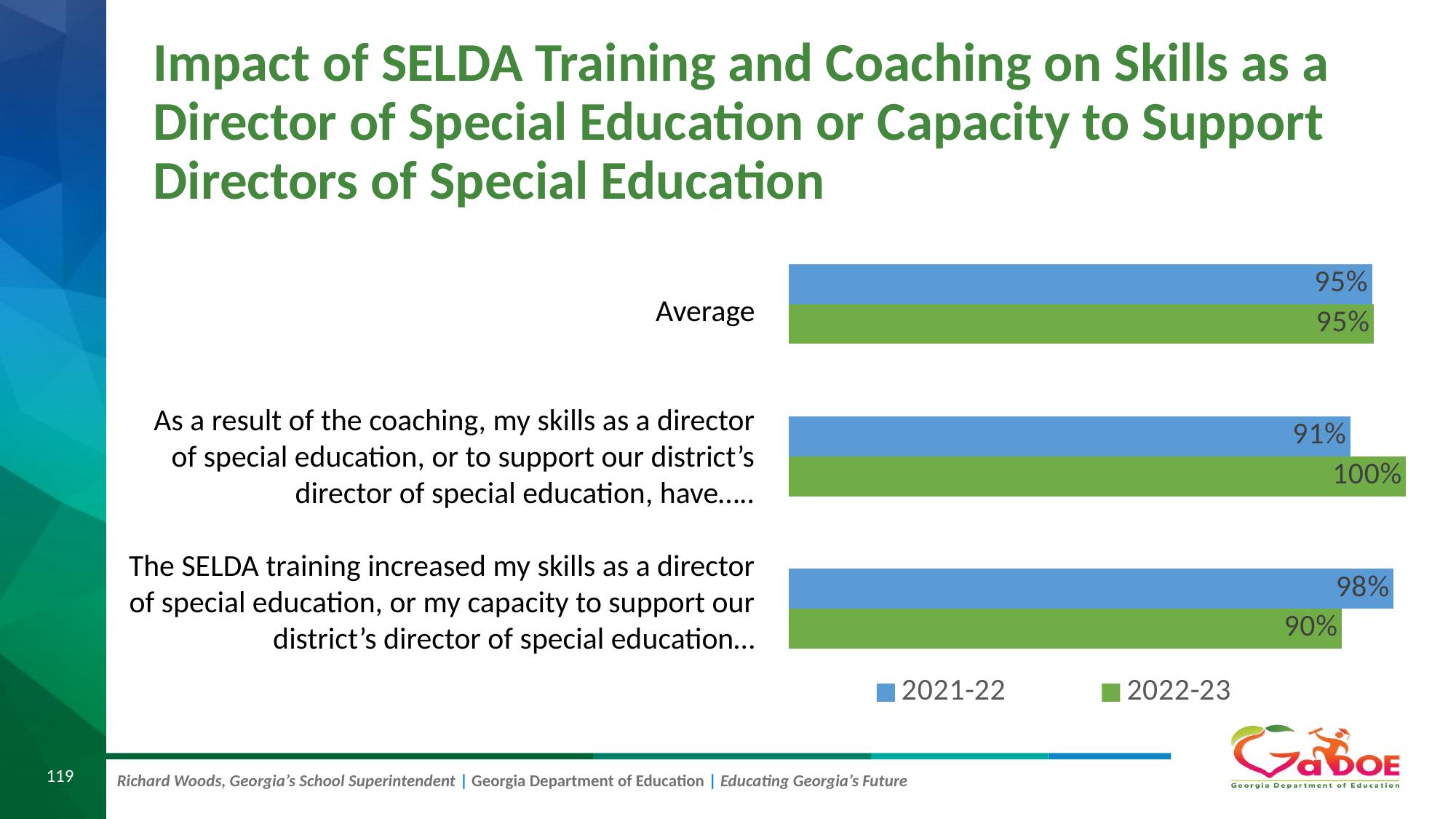
What is the difference between the 2022-23 and 2021-22 values for the category beginning 'As a result of the coaching...'? 9% What is the 2021-22 value for the category beginning 'The SELDA training increased my skills as a director...'? 98% What is the 2022-23 value for the category beginning 'As a result of the coaching, my skills as a director...'? 100% Which category has the lowest 2021-22 value? As a result of the coaching, my skills as a director of special education, or to support our district's director of special education, have….. Which category has the highest 2022-23 value? As a result of the coaching, my skills as a director of special education, or to support our district's director of special education, have….. How many categories are shown on the chart? 3 What is the 2022-23 value for the category beginning 'The SELDA training increased my skills as a director...'? 90% What kind of chart is shown on the slide? Bar chart For the category beginning 'The SELDA training increased my skills...', which series has the larger value, 2021-22 or 2022-23? 2021-22 How many series does the legend list? 2 Which colour represents the 2022-23 series? Green What is the 2021-22 value for Average? 95%